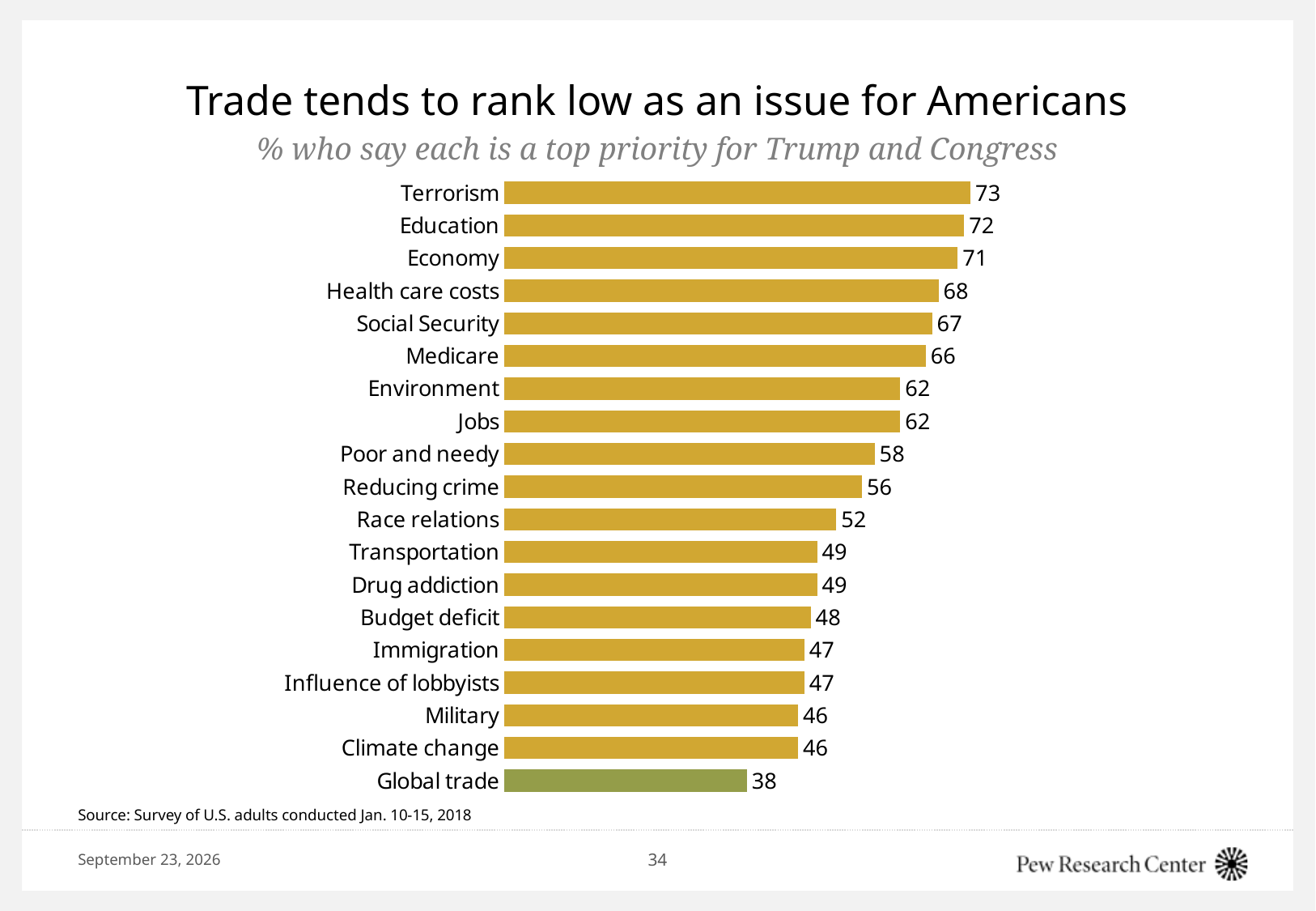
Which issue has the lowest percentage saying it is a top priority? Global trade How many issues are listed in the chart? 19 What is the value shown for Global trade? 38 What is the difference between the values for Terrorism and Global trade? 35 Which bar is shown in a different colour (green) from the others? Global trade Which has a higher value, Immigration or Race relations? Race relations What is the difference between the values for Health care costs and Reducing crime? 12 What percentage say Terrorism is a top priority for Trump and Congress? 73 Which issue has the highest percentage saying it is a top priority? Terrorism What is the value shown for Race relations? 52 What type of chart is shown on the slide? Bar chart Which has a higher value, Medicare or Poor and needy? Medicare